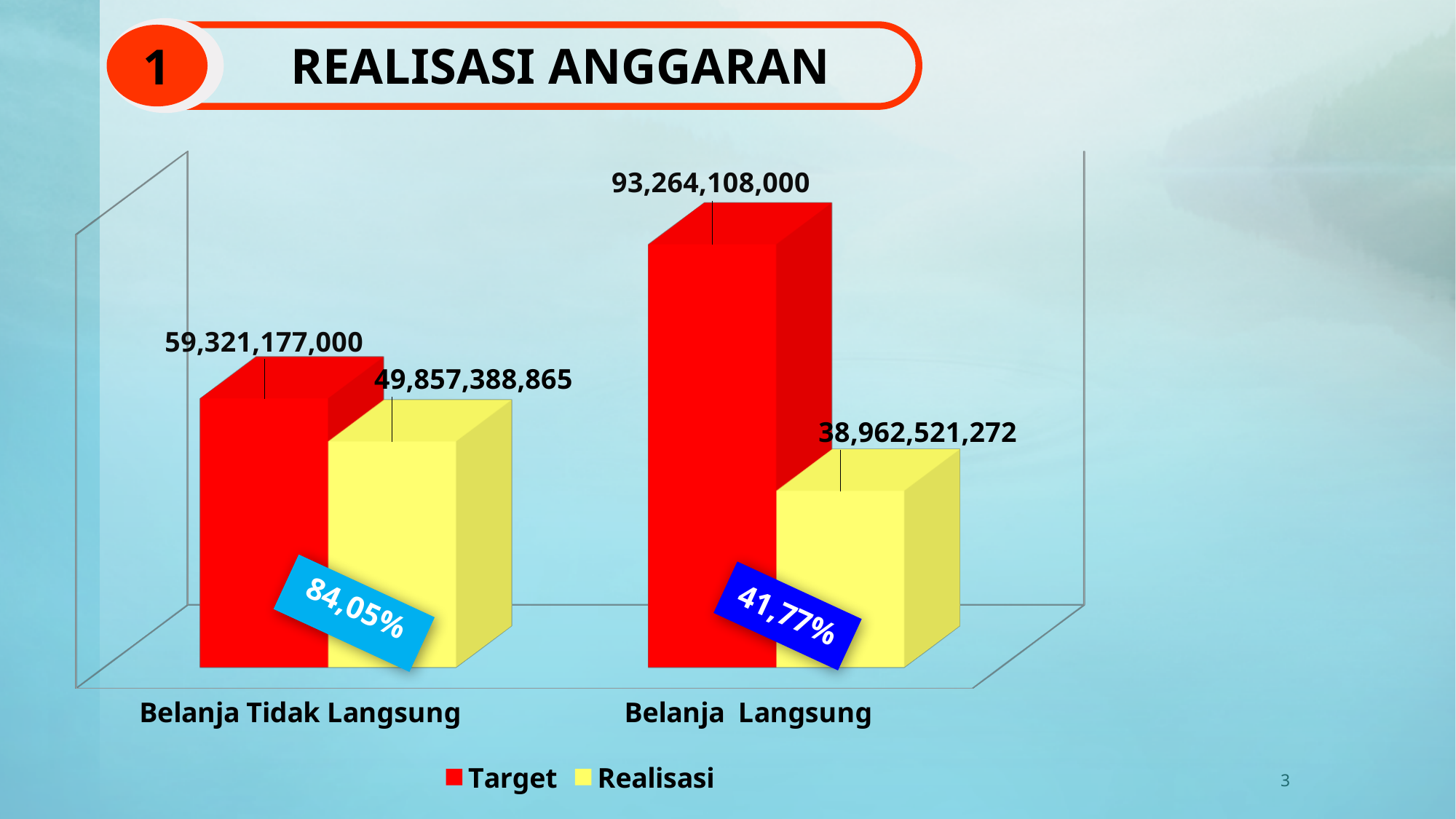
What is the difference between the Target and Realisasi values for Belanja Langsung? 54,301,586,728 What is the Realisasi value for Belanja Langsung? 38,962,521,272 What is the Target value for Belanja Langsung? 93,264,108,000 What is the Target value for Belanja Tidak Langsung? 59,321,177,000 What is the difference between the Target values for Belanja Langsung and Belanja Tidak Langsung? 33,942,931,000 Which is larger: the Realisasi value for Belanja Tidak Langsung or the Realisasi value for Belanja Langsung? Belanja Tidak Langsung Which category has the lowest Realisasi value? Belanja Langsung How many series does the legend list? 2 What is the Realisasi value for Belanja Tidak Langsung? 49,857,388,865 How many categories are shown on the x axis? 2 Which category has the highest Target value? Belanja Langsung What kind of chart is shown on the slide? Bar chart